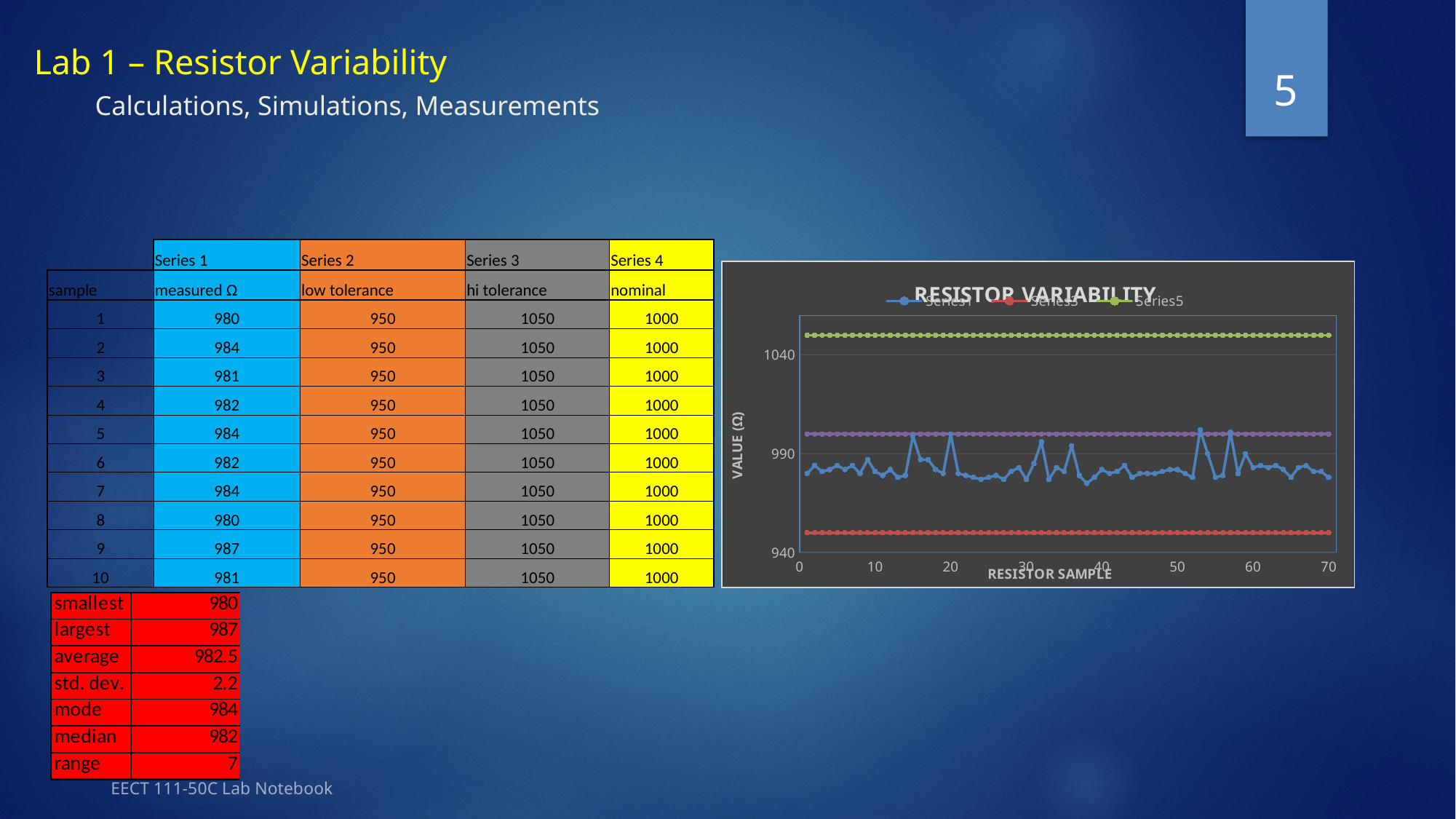
Does the green line rise, fall, or stay flat across the resistor samples? stays flat Which is higher on the chart, the purple line or the blue line? the purple line Is the value of the purple line greater or less than 990? greater Is the value of the red line greater or less than 990? less Which is higher on the chart, the green line or the red line? the green line What kind of chart is shown on the slide? line chart Which line in the chart sits lowest on the value axis? the red line What is the title of the chart? RESISTOR VARIABILITY What is the label on the vertical axis of the chart? VALUE (Ω) Which line in the chart sits highest on the value axis? the green line Is the value of the red line greater or less than 940? greater